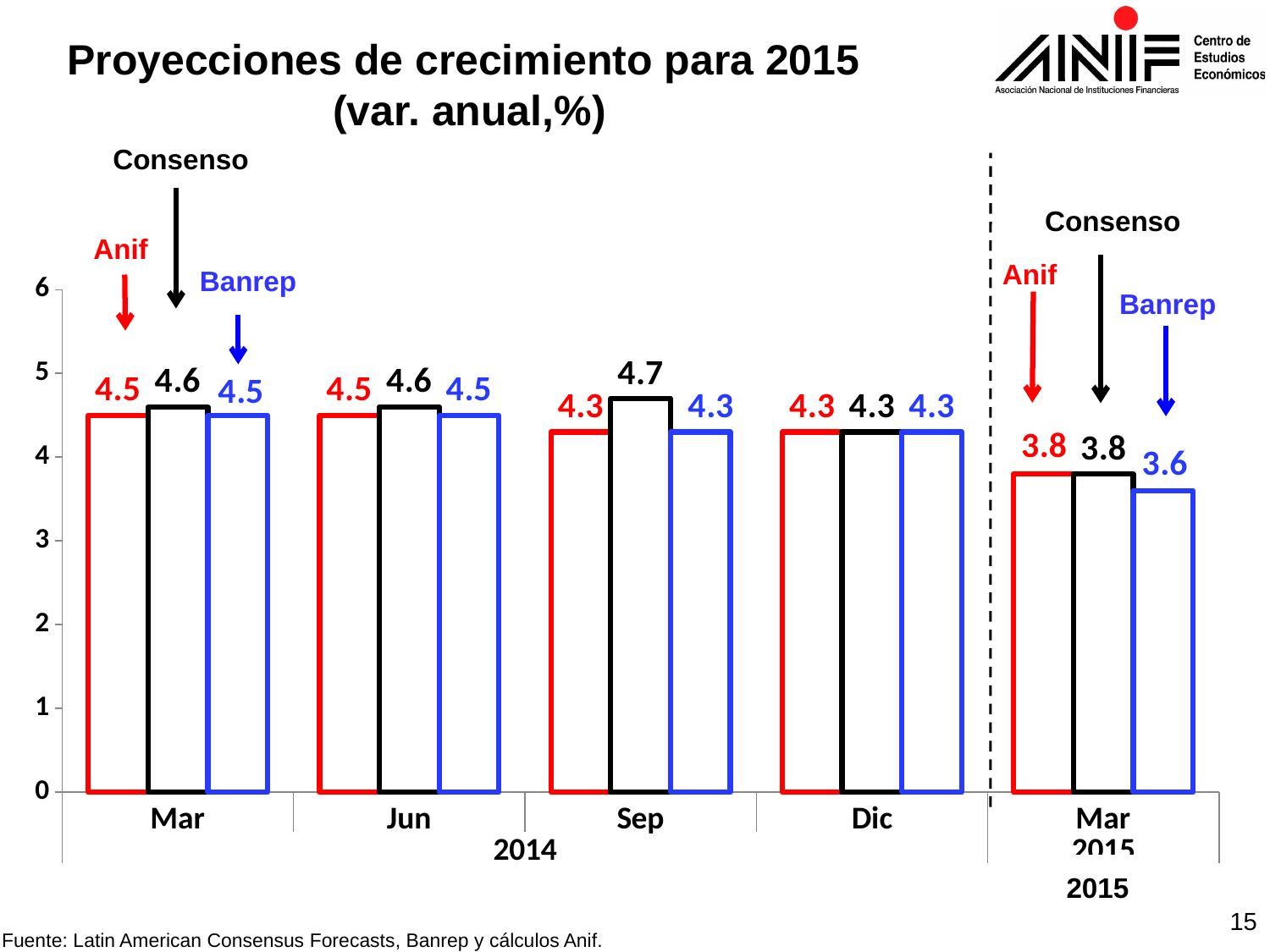
In which period is the Banrep projection lowest? Mar 2015 Which is larger for Mar 2015, the Anif projection or the Banrep projection? Anif In which period is the Consenso projection highest? Sep 2014 How many series (forecasters) are plotted in the chart? 3 How many time periods are shown on the x axis? 5 What is the Anif growth projection for Jun 2014? 4.5 What is the difference between the Consenso and Anif projections for Sep 2014? 0.4 What type of chart is shown on the slide? Bar chart What is the Anif growth projection for Dic 2014? 4.3 What is the Consenso growth projection for Sep 2014? 4.7 What is the Banrep growth projection for Mar 2015? 3.6 What is the difference between the Anif projection for Mar 2014 and for Mar 2015? 0.7